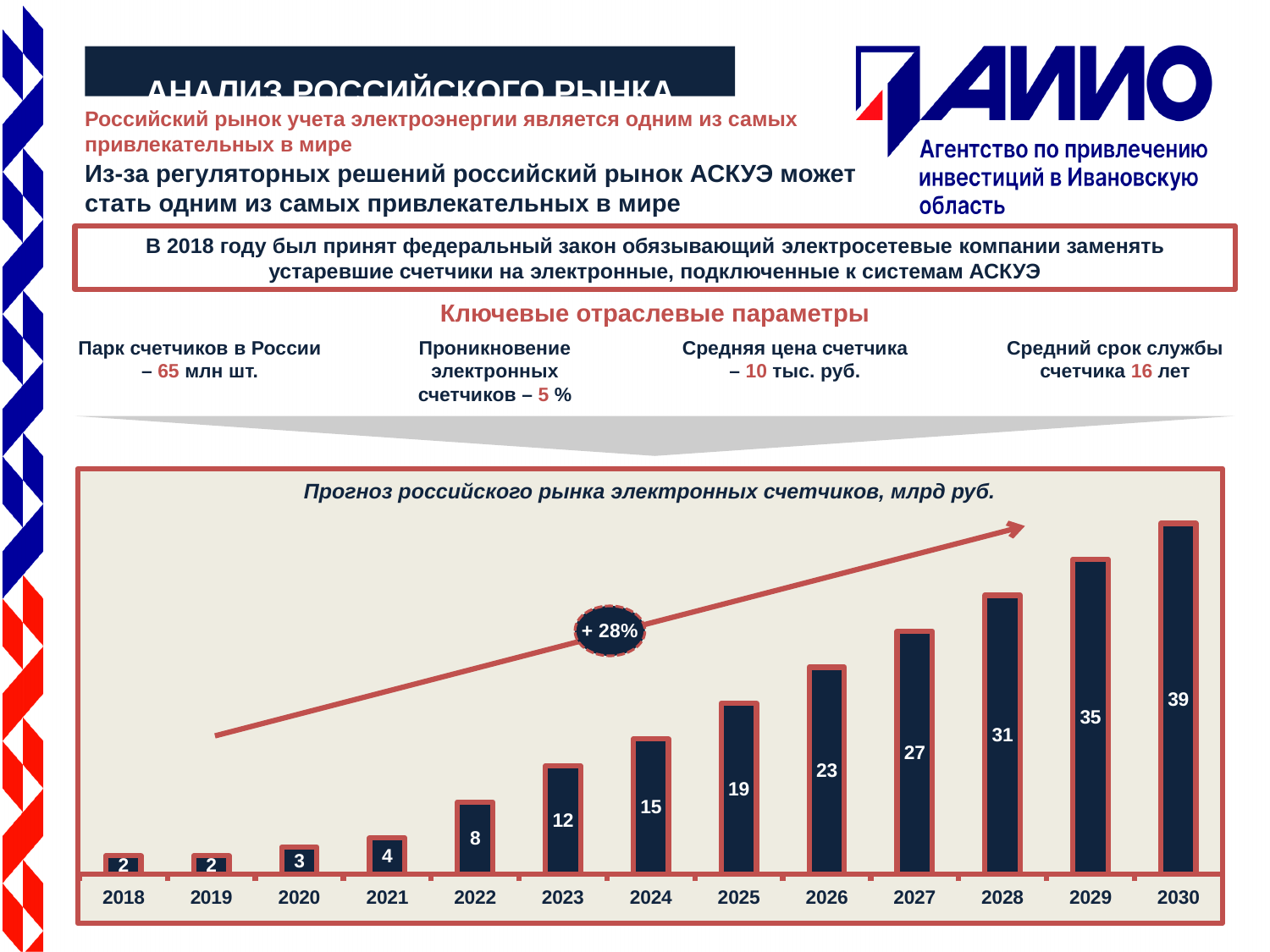
Do the values rise or fall from 2018 to 2030? rise Which is larger, the value for 2027 or the value for 2024? 2027 What is the forecast value for 2025 in the chart 'Прогноз российского рынка электронных счетчиков, млрд руб.'? 19 What is the difference between the values for 2026 and 2021? 19 What kind of chart is shown on the slide? bar chart What is the value shown for 2030 in the chart? 39 What is the title of the chart? Прогноз российского рынка электронных счетчиков, млрд руб. What is the value shown for 2022 in the chart? 8 Which year has the highest value in the chart? 2030 How many years are shown on the x axis of the chart? 13 What is the difference between the values for 2030 and 2029? 4 What growth rate is shown in the circle on the trend arrow? + 28%